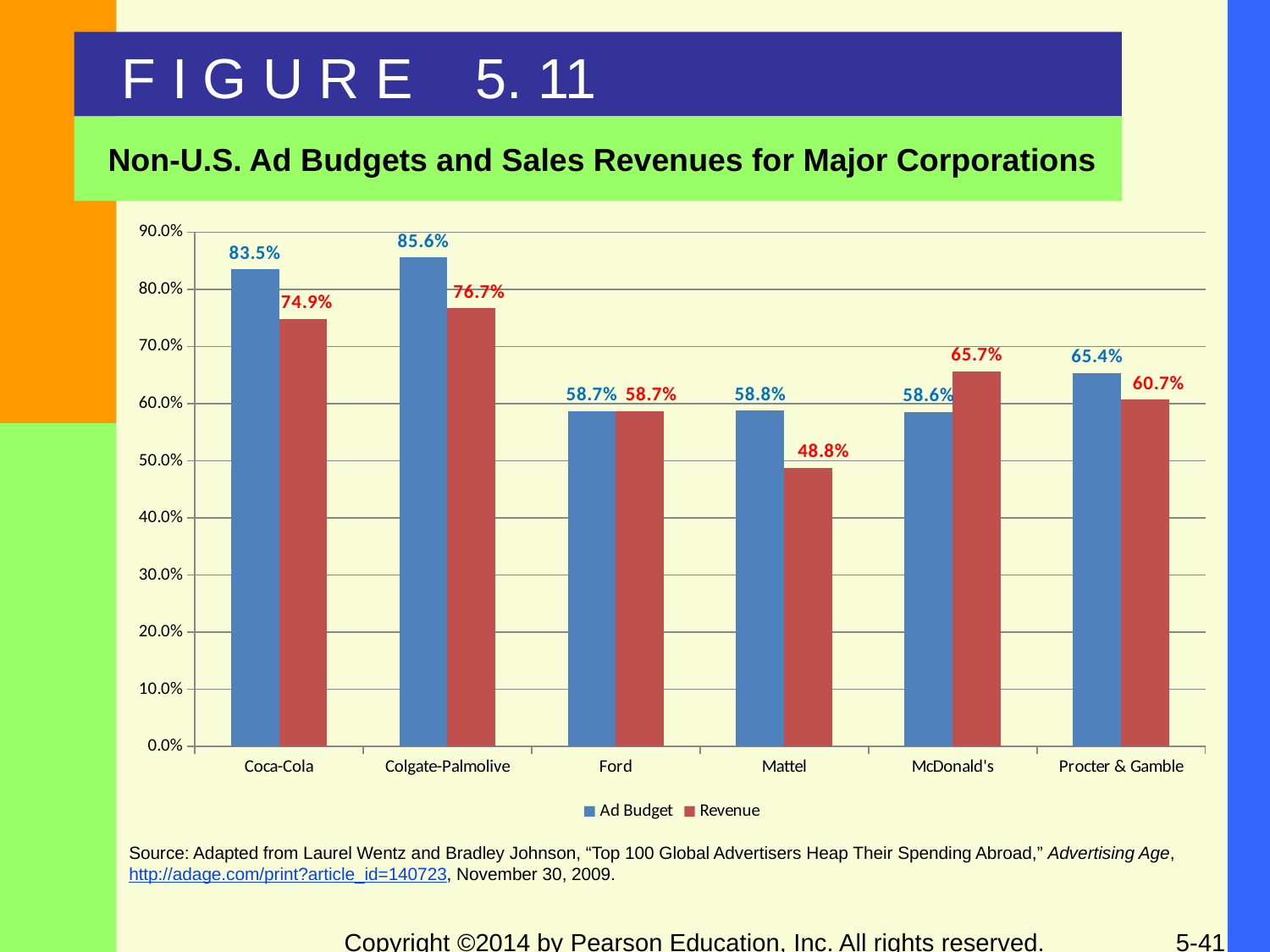
What is the difference between the Ad Budget and Revenue values for Coca-Cola? 8.6% What is the Revenue value for Mattel? 48.8% Which company has the highest Ad Budget value? Colgate-Palmolive What type of chart is shown on the slide? Bar chart How many series does the legend list? 2 Which is larger for McDonald's, the Ad Budget or the Revenue value? Revenue What is the Revenue value for McDonald's? 65.7% What is the difference between the Revenue values for Colgate-Palmolive and Procter & Gamble? 16.0% Is the Revenue value for Mattel greater or less than 50.0%? less Which company has the lowest Revenue value? Mattel How many companies are shown on the x axis? 6 What is the Ad Budget value for Coca-Cola? 83.5%